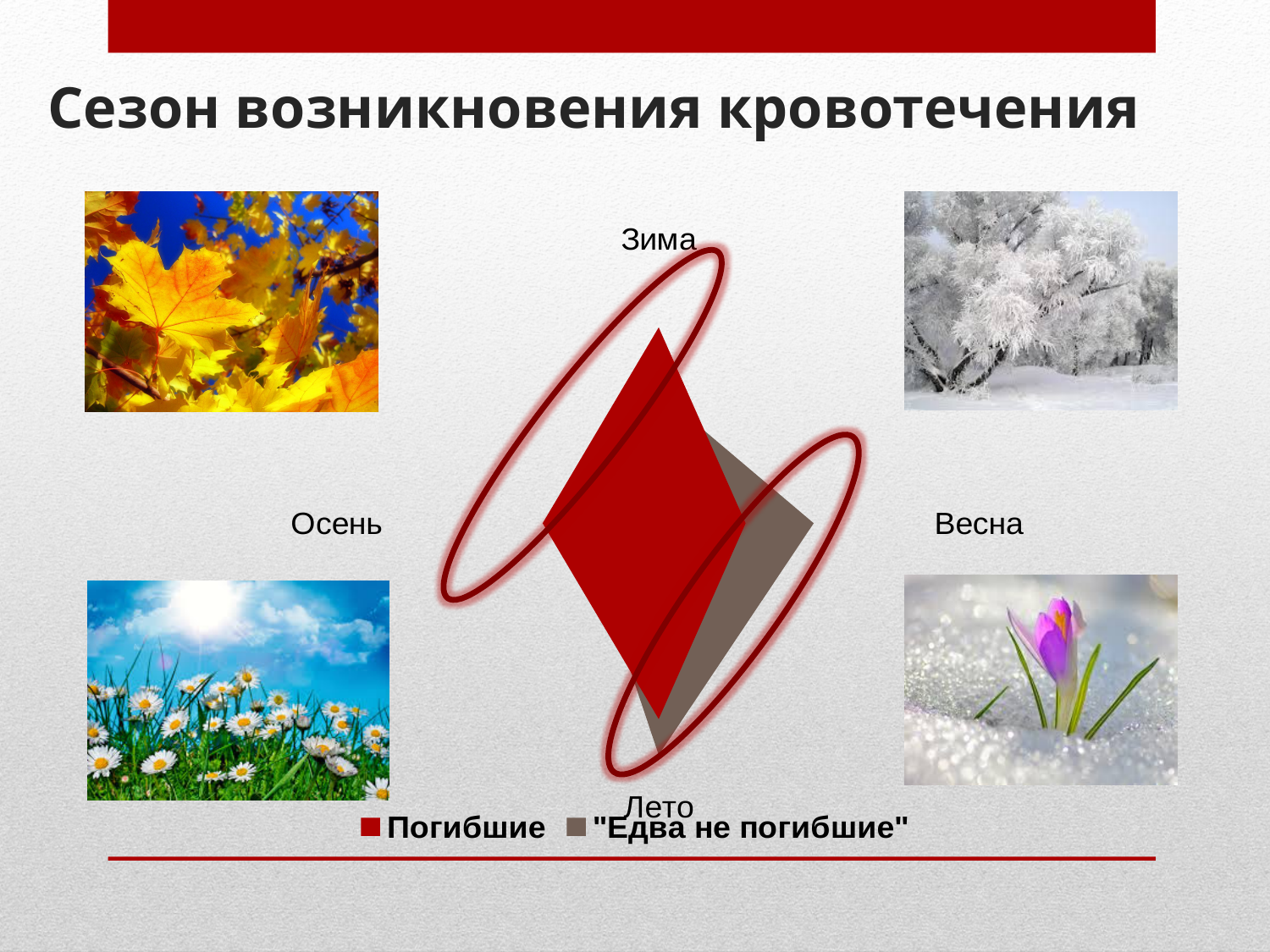
What is the title of the slide containing the chart? Сезон возникновения кровотечения How many series does the legend list? 2 For Весна, which series extends further from the centre, Погибшие or "Едва не погибшие"? "Едва не погибшие" Which category is at the top of the radar chart? Зима How many categories (seasons) does the chart have? 4 For Зима, which series extends further from the centre, Погибшие or "Едва не погибшие"? Погибшие What kind of chart is shown on the slide? radar chart What are the two series named in the legend? Погибшие and "Едва не погибшие"